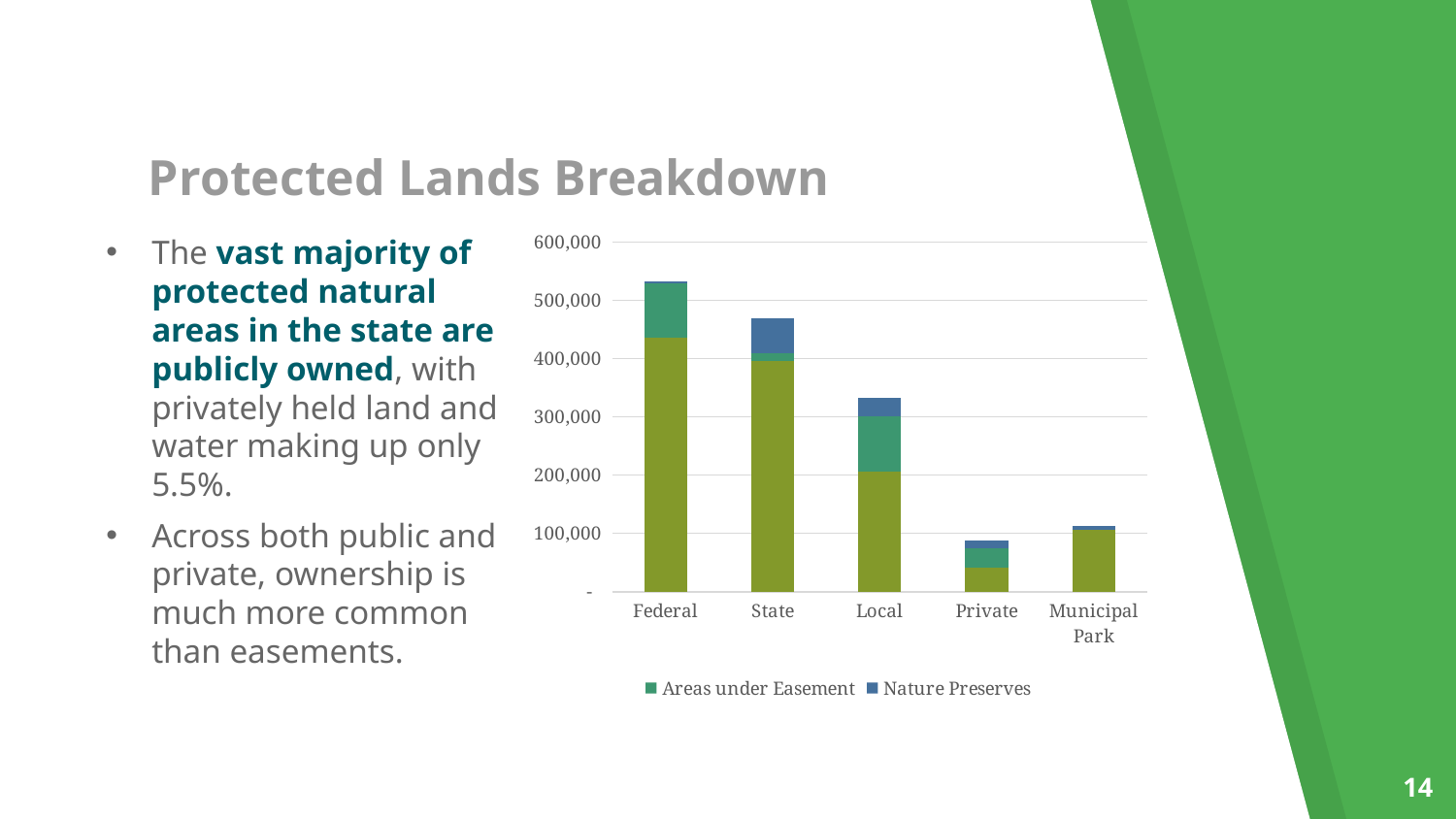
Which stacked bar is taller, Municipal Park or Private? Municipal Park How many series does the chart's legend list? 2 Which stacked bar is taller, Federal or State? Federal Is the total value for Federal greater or less than 500,000? greater Which category has the tallest stacked bar? Federal How many categories are shown on the x axis of the chart? 5 Is the total value for State greater or less than 400,000? greater Which category has the shortest stacked bar? Private What are the two series names listed in the chart's legend? Areas under Easement and Nature Preserves Is the total value for Local greater or less than 400,000? less What kind of chart is shown on the slide? Stacked bar chart